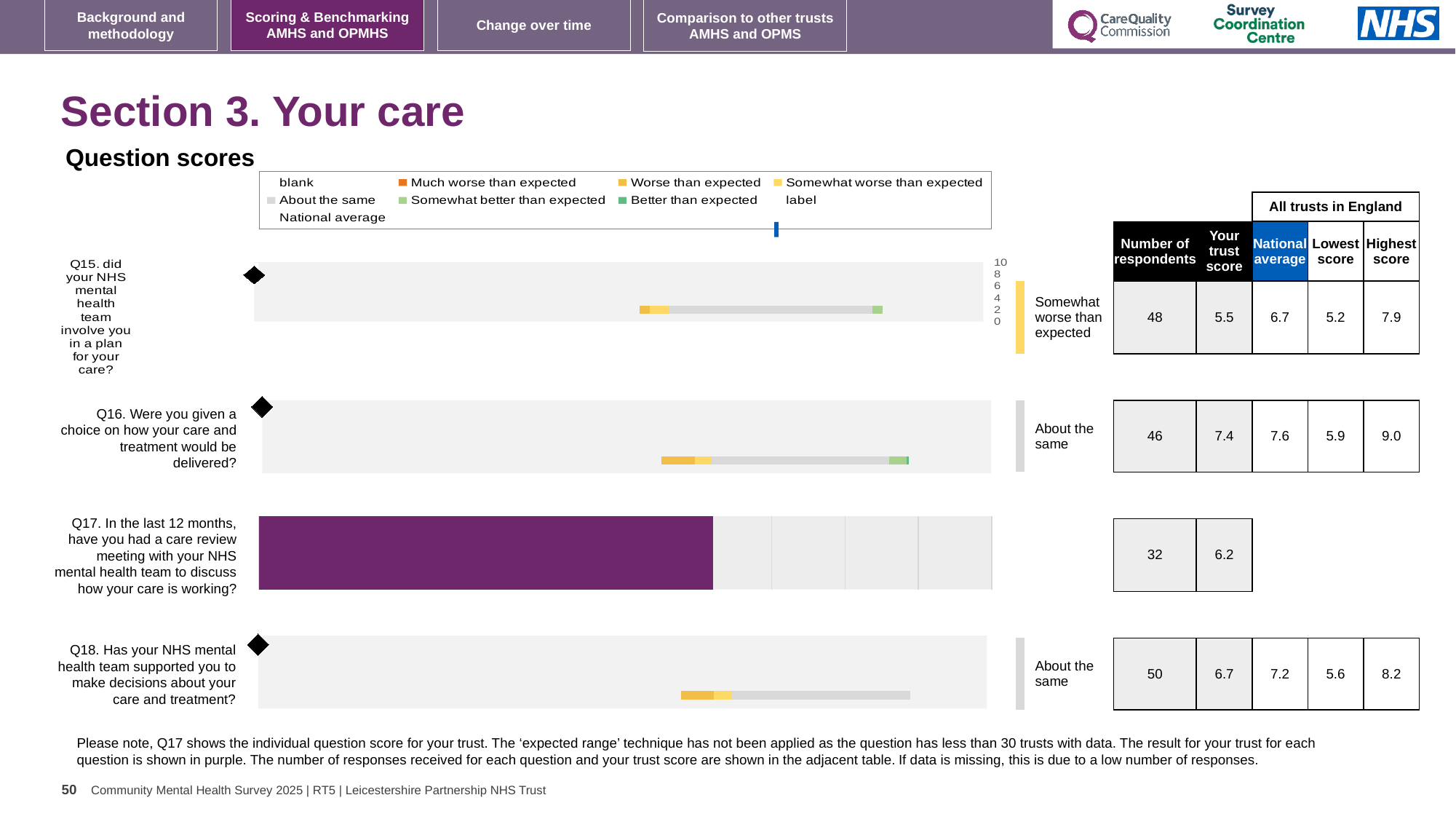
What is the highest score across all trusts in England for Q16? 9.0 Is the trust score bar for Q17 greater or less than 4? greater Which question has the highest trust score? Q16 What is the trust score for Q15 (did your NHS mental health team involve you in a plan for your care)? 5.5 For Q18, which is larger: the trust score or the national average? National average What is the lowest score across all trusts in England for Q18? 5.6 What is the difference between the national average and the trust score for Q15? 1.2 What is the national average score for Q16 (were you given a choice on how your care and treatment would be delivered)? 7.6 How many respondents answered Q18 (has your NHS mental health team supported you to make decisions about your care and treatment)? 50 Which question has the fewest respondents? Q17 How many questions are plotted in the chart? 4 What benchmark category is shown for Q15? Somewhat worse than expected